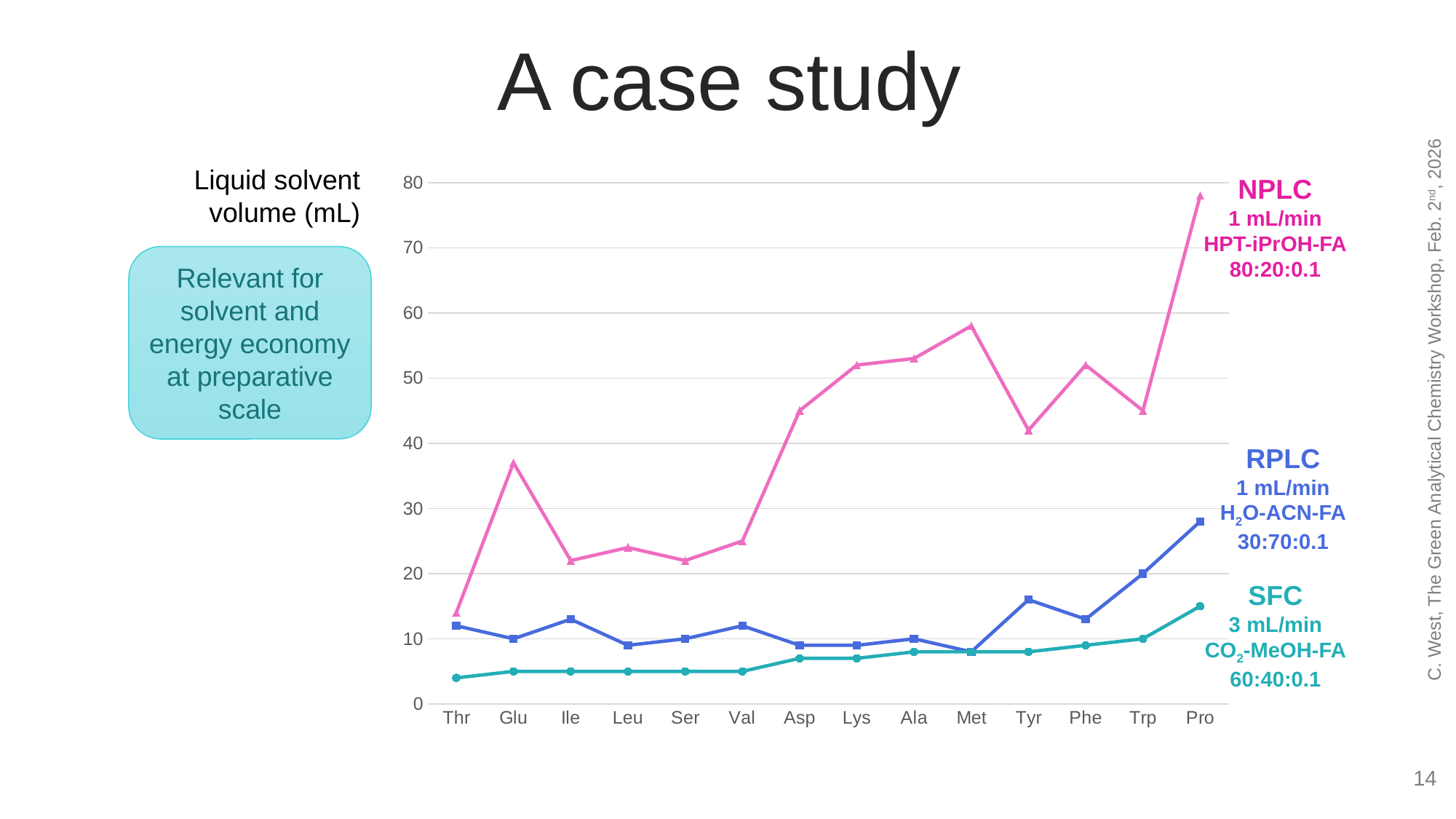
Which is larger for the NPLC series: the value for Glu or the value for Ile? Glu What kind of chart is shown on the slide? line chart How many amino acids are listed along the x axis of the chart? 14 For which amino acid does the SFC series have its lowest liquid solvent volume? Thr Is the RPLC value for Pro greater or less than 20? greater What flow rate is stated for the SFC series in the chart's legend? 3 mL/min Is the NPLC value for Pro greater or less than 70? greater Does the SFC series generally rise or fall from Thr to Pro along the x axis? rise Is the SFC value for Thr greater or less than 10? less For which amino acid does the NPLC series reach its highest liquid solvent volume? Pro How many series (chromatographic methods) are plotted on the chart? 3